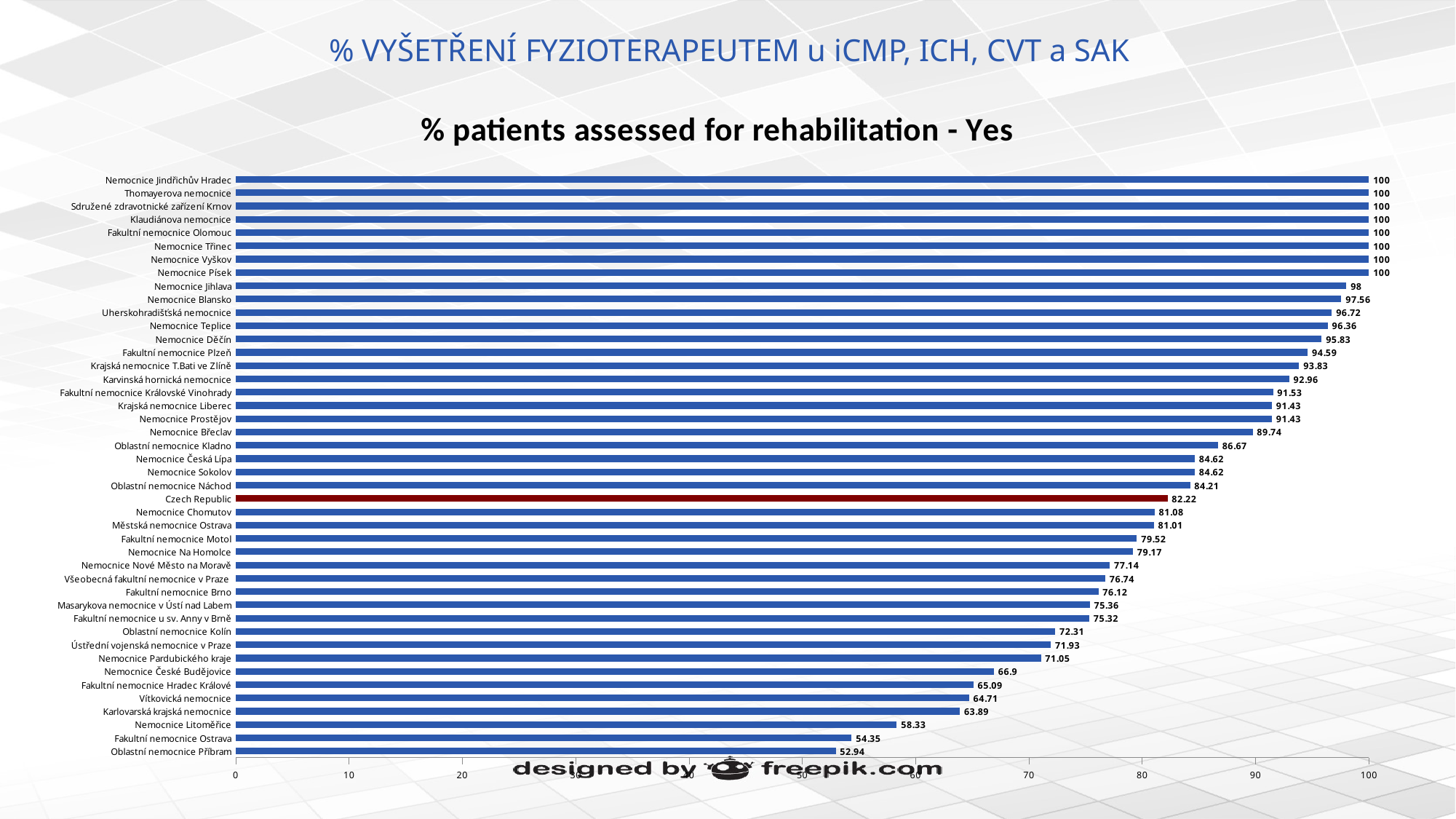
Which bar is shown in a different colour (red) from the others? Czech Republic What is the value for Fakultní nemocnice Motol? 79.52 What kind of chart is shown on the slide? bar chart What is the value for Nemocnice Jihlava? 98 Is the value for Nemocnice České Budějovice greater or less than 70? less How many categories are shown on the chart? 44 What is the value for Czech Republic? 82.22 What is the difference between the values for Nemocnice Blansko and Nemocnice Jihlava? 0.44 Which is larger, the value for Fakultní nemocnice Brno or the value for Fakultní nemocnice Ostrava? Fakultní nemocnice Brno Which category has the lowest value? Oblastní nemocnice Příbram What is the difference between the values for Czech Republic and Oblastní nemocnice Příbram? 29.28 What is the value for Nemocnice Litoměřice? 58.33